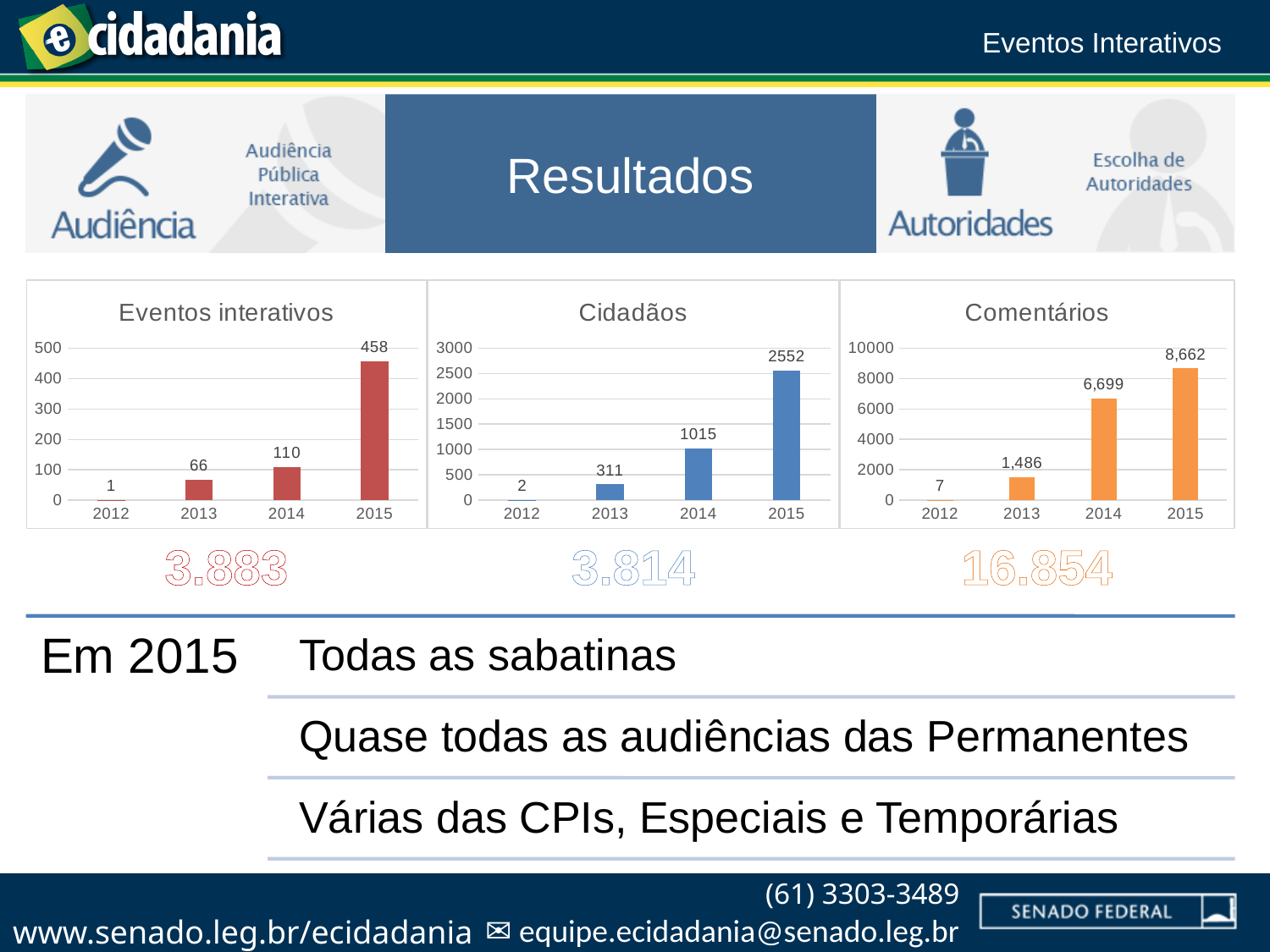
In the 'Eventos interativos' chart, what is the difference between the values for 2015 and 2014? 348 What kind of chart is the 'Comentários' chart? bar chart In the 'Cidadãos' chart, which is larger, the value for 2013 or the value for 2014? 2014 In the 'Eventos interativos' chart, do the values rise or fall from 2012 to 2015? rise In the 'Cidadãos' chart, is the value for 2015 greater or less than 2000? greater How many years are shown on the x axis of the 'Eventos interativos' chart? 4 In the 'Comentários' chart, what is the difference between the values for 2015 and 2014? 1,963 In the 'Cidadãos' chart, what is the value for 2014? 1015 In the 'Comentários' chart, what is the value for 2013? 1,486 In the 'Eventos interativos' chart, what is the value for 2015? 458 In the 'Comentários' chart, which year has the highest value? 2015 In the 'Cidadãos' chart, which year has the lowest value? 2012